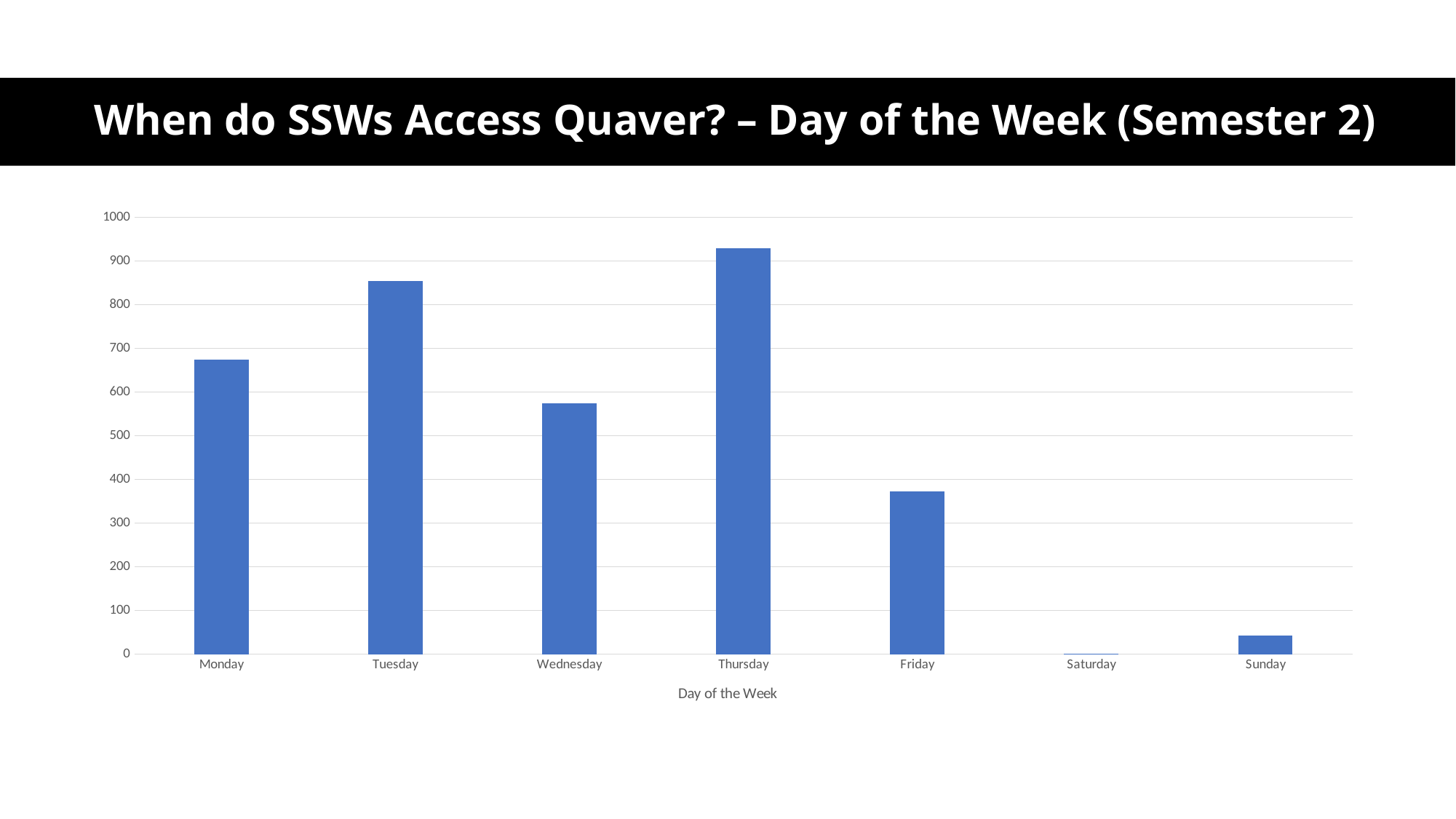
Is the value for Wednesday greater or less than 500? greater What is the label of the x axis? Day of the Week Is the value for Monday greater or less than 600? greater Is the value for Friday greater or less than 400? less Which is larger, the value for Tuesday or the value for Wednesday? Tuesday What kind of chart is shown on the slide? bar chart Which is larger, the value for Friday or the value for Monday? Monday Which day has the lowest value? Saturday How many days of the week are plotted on the chart? 7 Which day has the highest value? Thursday